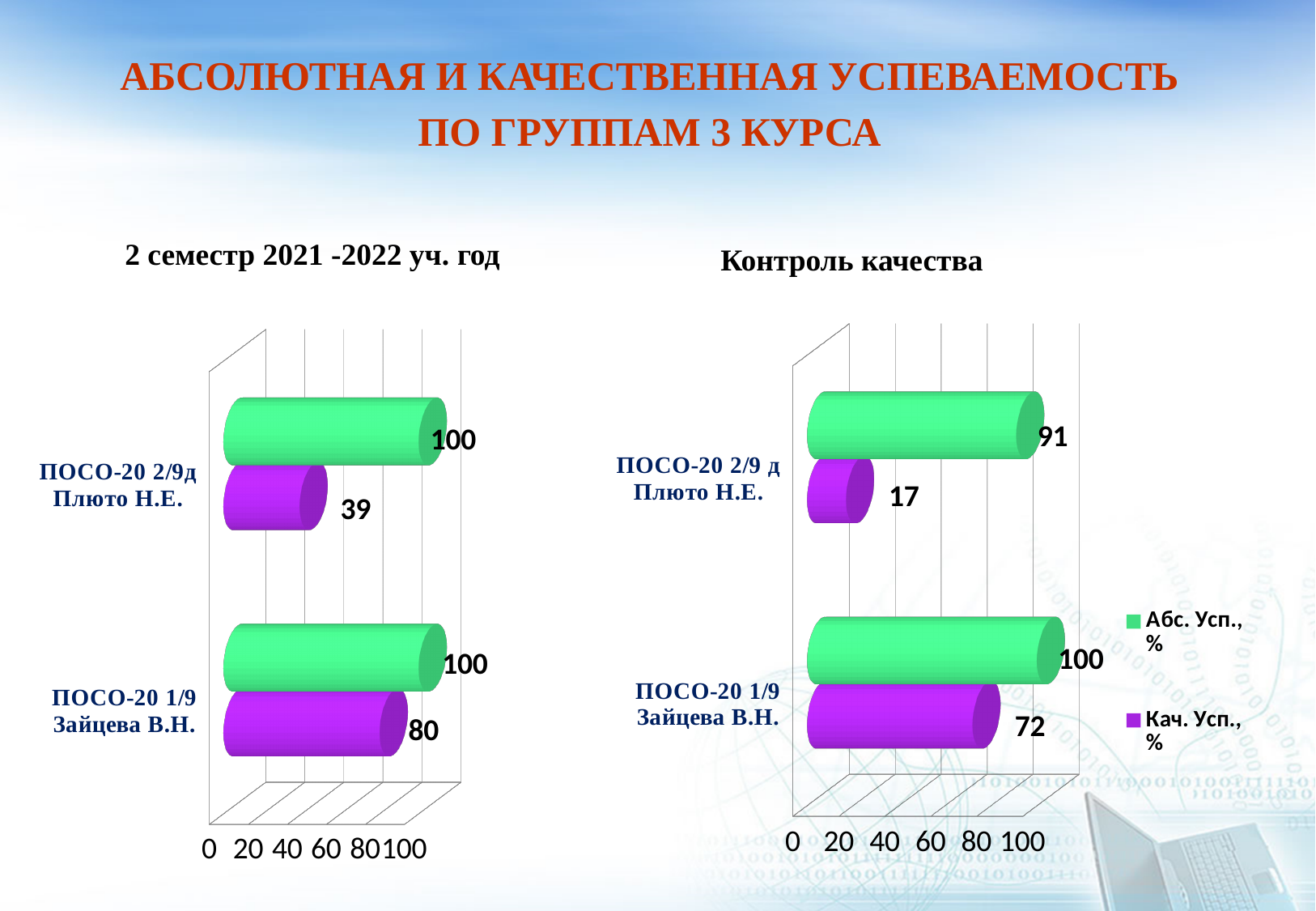
What type of chart is the chart titled "Контроль качества"? Bar chart In the chart titled "2 семестр 2021 -2022 уч. год", what is the difference between the Кач. Усп., % values of ПОСО-20 1/9 Зайцева В.Н. and ПОСО-20 2/9д Плюто Н.Е.? 41 In the chart titled "Контроль качества", which colour represents Кач. Усп., %? Purple In the chart titled "Контроль качества", which is larger: the Абс. Усп., % value for ПОСО-20 2/9 д Плюто Н.Е. or for ПОСО-20 1/9 Зайцева В.Н.? ПОСО-20 1/9 Зайцева В.Н. In the chart titled "Контроль качества", which group has the lowest Кач. Усп., % value? ПОСО-20 2/9 д Плюто Н.Е. In the chart titled "Контроль качества", what is the Кач. Усп., % value for ПОСО-20 1/9 Зайцева В.Н.? 72 In the chart titled "Контроль качества", what is the Абс. Усп., % value for ПОСО-20 2/9 д Плюто Н.Е.? 91 In the chart titled "2 семестр 2021 -2022 уч. год", what is the Кач. Усп., % value for ПОСО-20 2/9д Плюто Н.Е.? 39 How many groups are shown in the chart titled "2 семестр 2021 -2022 уч. год"? 2 In the chart titled "Контроль качества", what is the difference between the Абс. Усп., % and Кач. Усп., % values for ПОСО-20 2/9 д Плюто Н.Е.? 74 How many series does the legend of the chart titled "Контроль качества" list? 2 In the chart titled "2 семестр 2021 -2022 уч. год", what is the Абс. Усп., % value for ПОСО-20 1/9 Зайцева В.Н.? 100